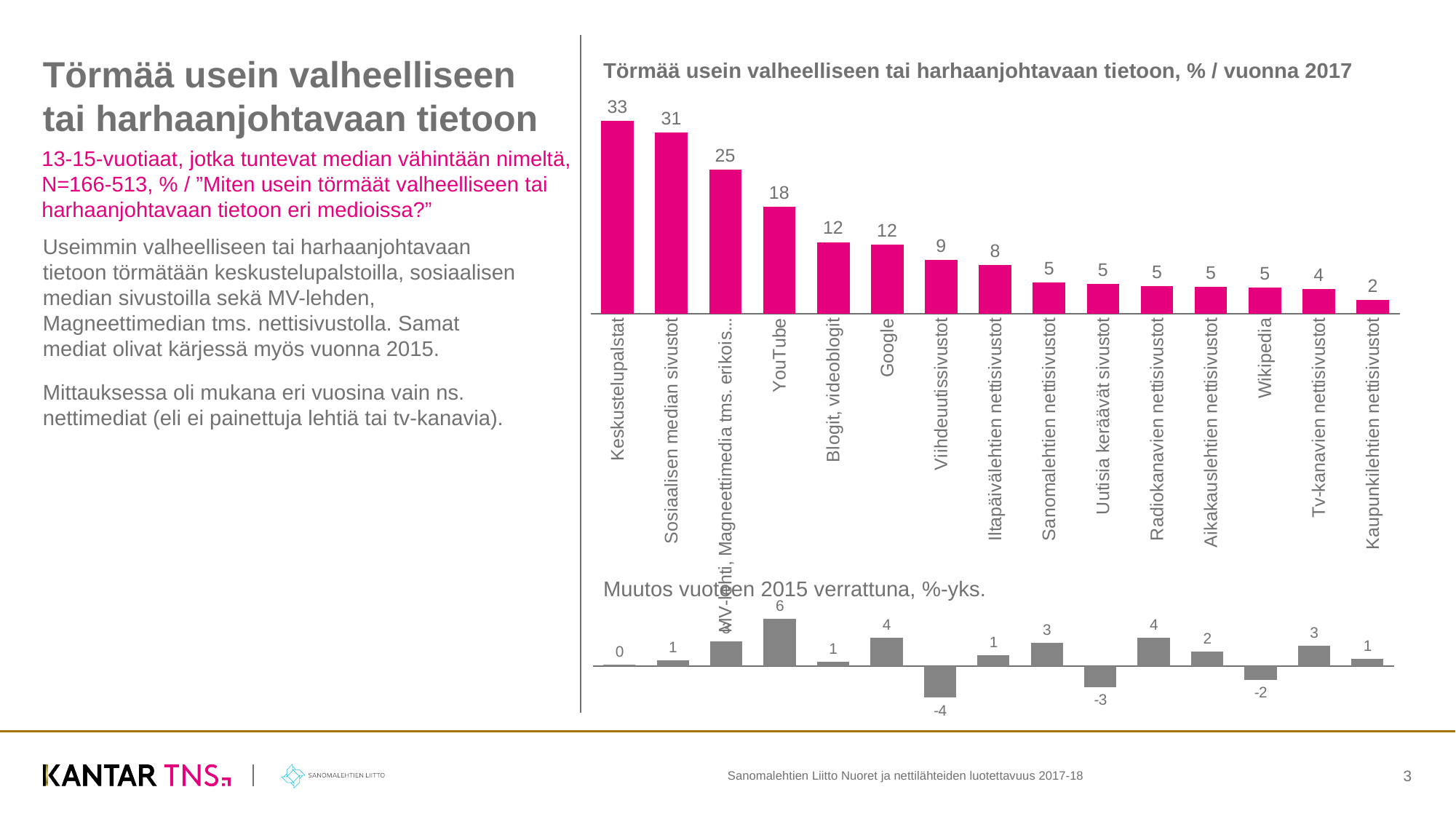
How many categories are shown in the top chart? 15 In the bottom chart (Muutos vuoteen 2015 verrattuna), what is the value for YouTube? 6 In the top chart, what is the value for YouTube? 18 In the bottom chart (Muutos vuoteen 2015 verrattuna), what is the value for Viihdeuutissivustot? -4 In the top chart, which category has the lowest value? Kaupunkilehtien nettisivustot In the top chart, what is the value for Keskustelupalstat? 33 What kind of chart is the top chart? Bar chart In the top chart, what is the difference between Keskustelupalstat and Sosiaalisen median sivustot? 2 In the top chart, which category has the highest value? Keskustelupalstat What is the title of the top chart? Törmää usein valheelliseen tai harhaanjohtavaan tietoon, % / vuonna 2017 In the top chart, what is the value for Wikipedia? 5 In the top chart, which is larger, the value for YouTube or the value for Google? YouTube